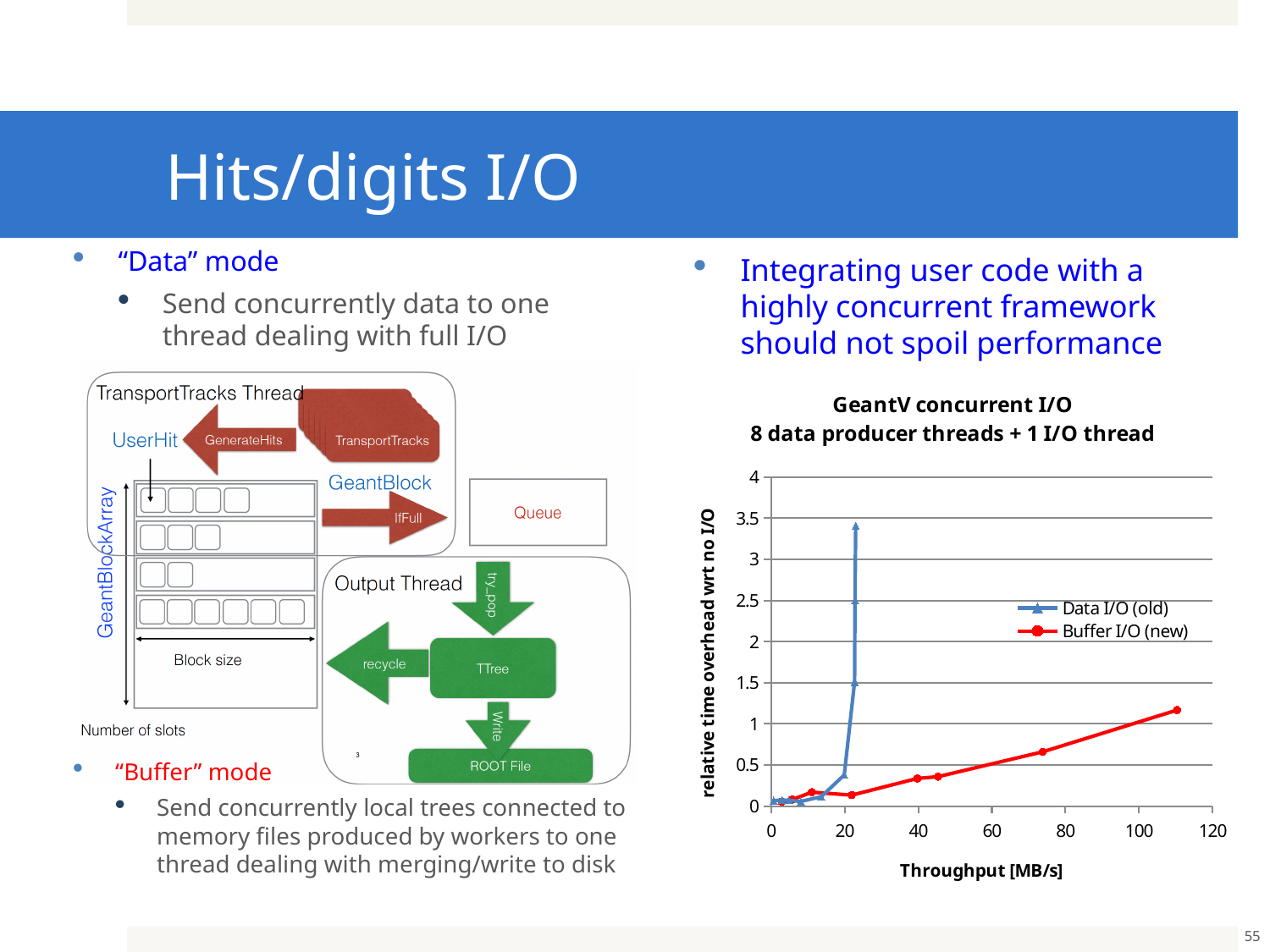
What are the two series named in the chart legend? Data I/O (old) and Buffer I/O (new) What is the label of the x axis of the chart? Throughput [MB/s] What kind of chart is shown on the slide? line chart What is the maximum value shown on the y axis of the chart? 4 Is the value of the Buffer I/O (new) series at a throughput of about 40 MB/s greater or less than 0.5? less How many series does the chart legend list? 2 Which series reaches the highest relative time overhead in the chart? Data I/O (old) Is the value of the Buffer I/O (new) series at its highest throughput point (around 110 MB/s) greater or less than 1? greater Which series extends to the highest throughput value in the chart? Buffer I/O (new) Does the Buffer I/O (new) series rise or fall as throughput increases? rise Is the highest value of the Data I/O (old) series greater or less than 3? greater At a throughput of about 20 MB/s, which series has the higher relative time overhead? Data I/O (old)